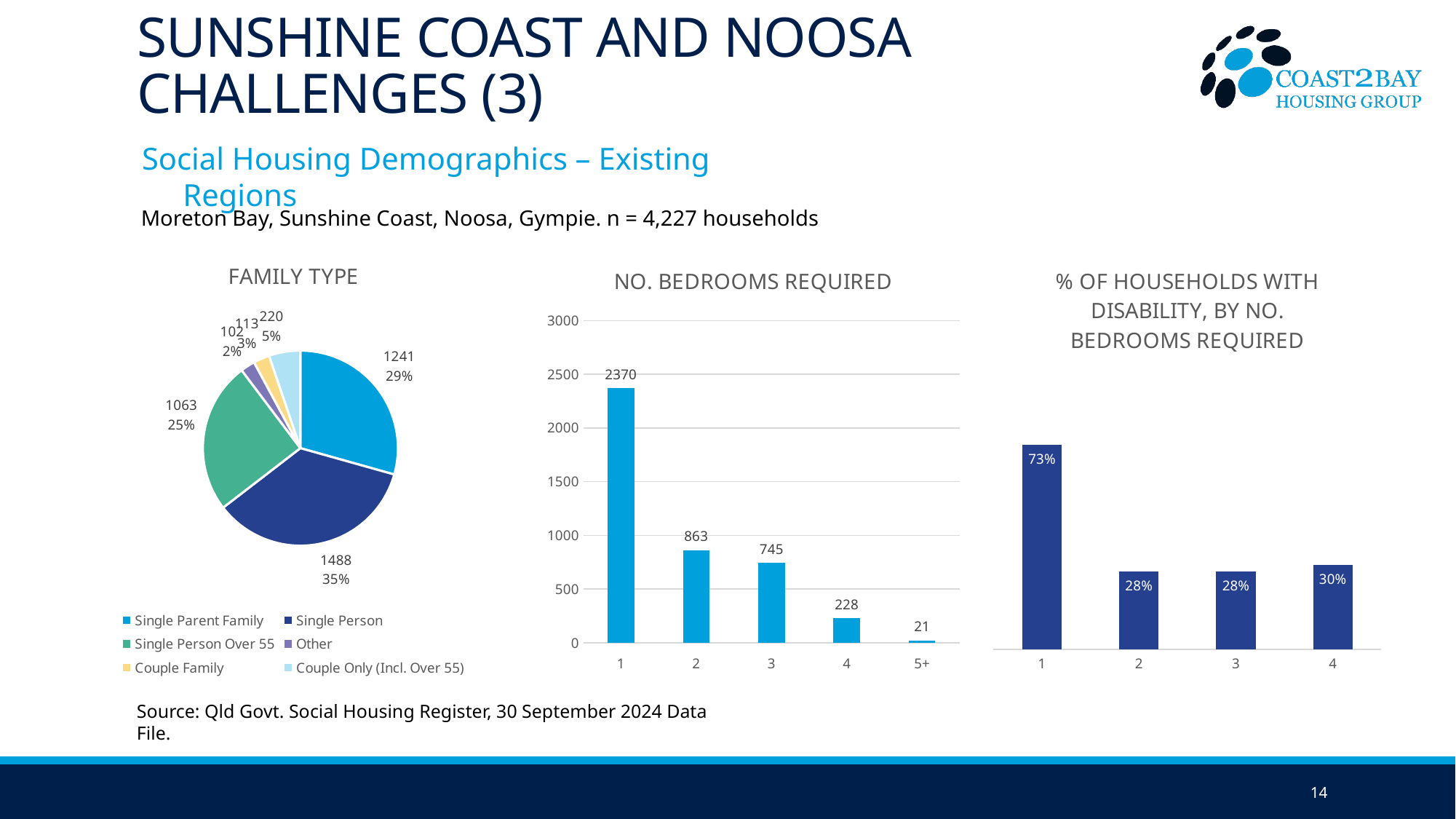
What kind of chart is the NO. BEDROOMS REQUIRED chart? Bar chart In the % OF HOUSEHOLDS WITH DISABILITY, BY NO. BEDROOMS REQUIRED chart, which is larger, the value for 2 bedrooms or 4 bedrooms? 4 bedrooms In the FAMILY TYPE pie chart, how many households are Single Person? 1488 In the FAMILY TYPE pie chart, which family type has the largest slice? Single Person In the NO. BEDROOMS REQUIRED chart, do the values rise or fall as the number of bedrooms increases? Fall In the NO. BEDROOMS REQUIRED chart, which category has the lowest value? 5+ How many family types does the legend of the FAMILY TYPE pie chart list? 6 In the NO. BEDROOMS REQUIRED chart, what is the difference between the values for 2 bedrooms and 3 bedrooms? 118 In the FAMILY TYPE pie chart, what share of households are Single Person Over 55? 25% In the FAMILY TYPE pie chart, which family type has the smallest slice? Other In the NO. BEDROOMS REQUIRED chart, what is the value for 1 bedroom? 2370 In the % OF HOUSEHOLDS WITH DISABILITY, BY NO. BEDROOMS REQUIRED chart, what is the value for 1 bedroom? 73%